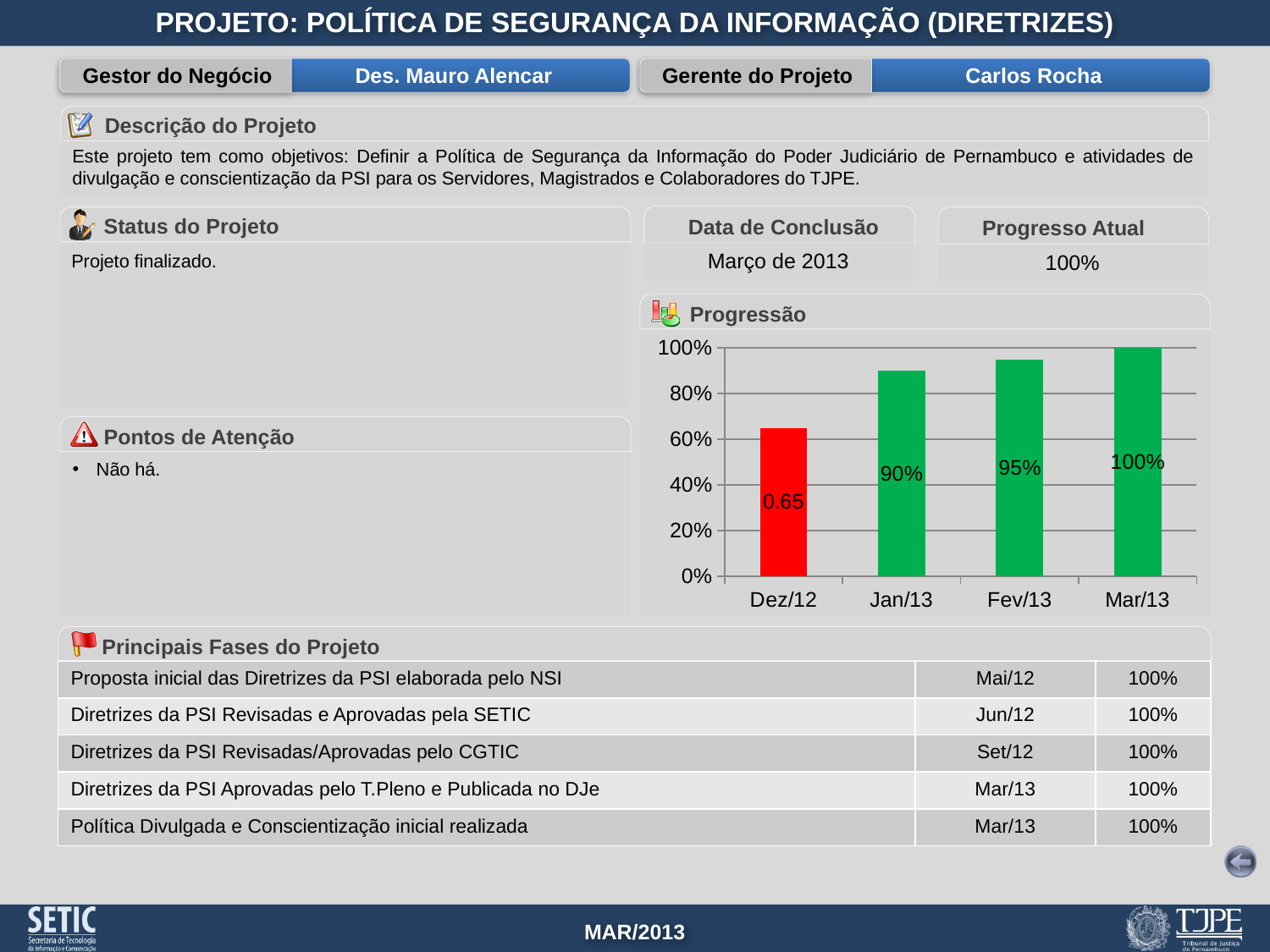
In the Progressão chart, which is larger, the value for Fev/13 or the value for Jan/13? Fev/13 Which month has the highest value in the Progressão chart? Mar/13 What is the value shown for Jan/13 in the Progressão chart? 90% Which month has the lowest value in the Progressão chart? Dez/12 Is the value for Dez/12 in the Progressão chart greater or less than 80%? less What is the difference between the values for Mar/13 and Jan/13 in the Progressão chart? 10% How many months are shown on the x axis of the Progressão chart? 4 What is the value shown for Fev/13 in the Progressão chart? 95% What is the difference between the values for Fev/13 and Jan/13 in the Progressão chart? 5% What is the value shown for Mar/13 in the Progressão chart? 100% What type of chart is the Progressão chart? bar chart What data label is printed on the Dez/12 bar in the Progressão chart? 0.65